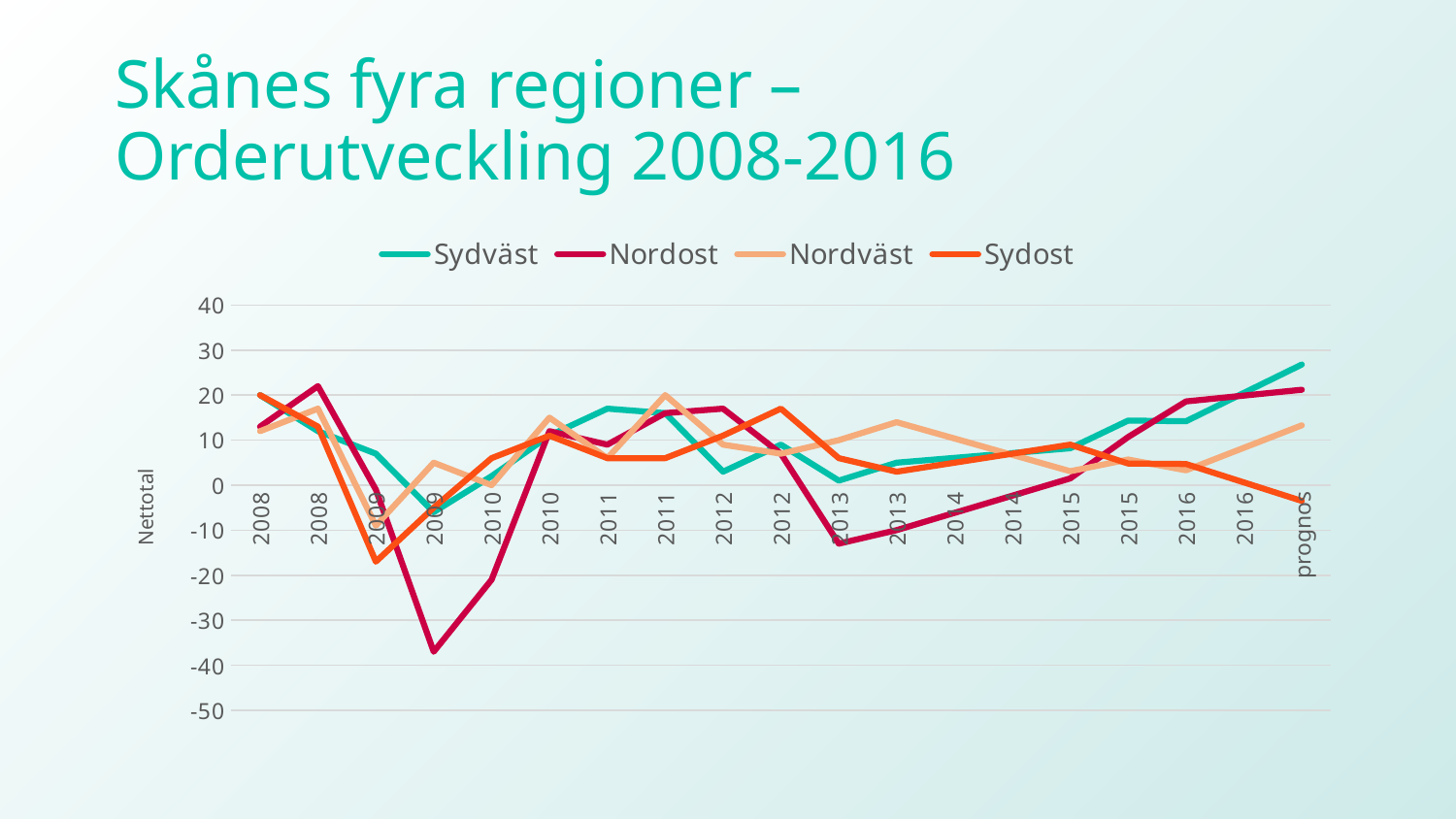
At the 'prognos' point, which is larger: the value for Sydväst or the value for Sydost? Sydväst Is the value for Nordost at the second 2009 point greater or less than -30? less What is the label of the vertical axis? Nettotal Which series has the highest value at the 'prognos' point? Sydväst Is the value for Sydväst at the 'prognos' point greater or less than 20? greater Which series reaches the lowest value anywhere on the chart? Nordost Is the value for Sydost at the first 2009 point greater or less than -10? less How many points are plotted along the x axis for each series? 19 What kind of chart is shown on the slide? line chart How many series does the legend list? 4 Which series are listed in the legend? Sydväst, Nordost, Nordväst, Sydost